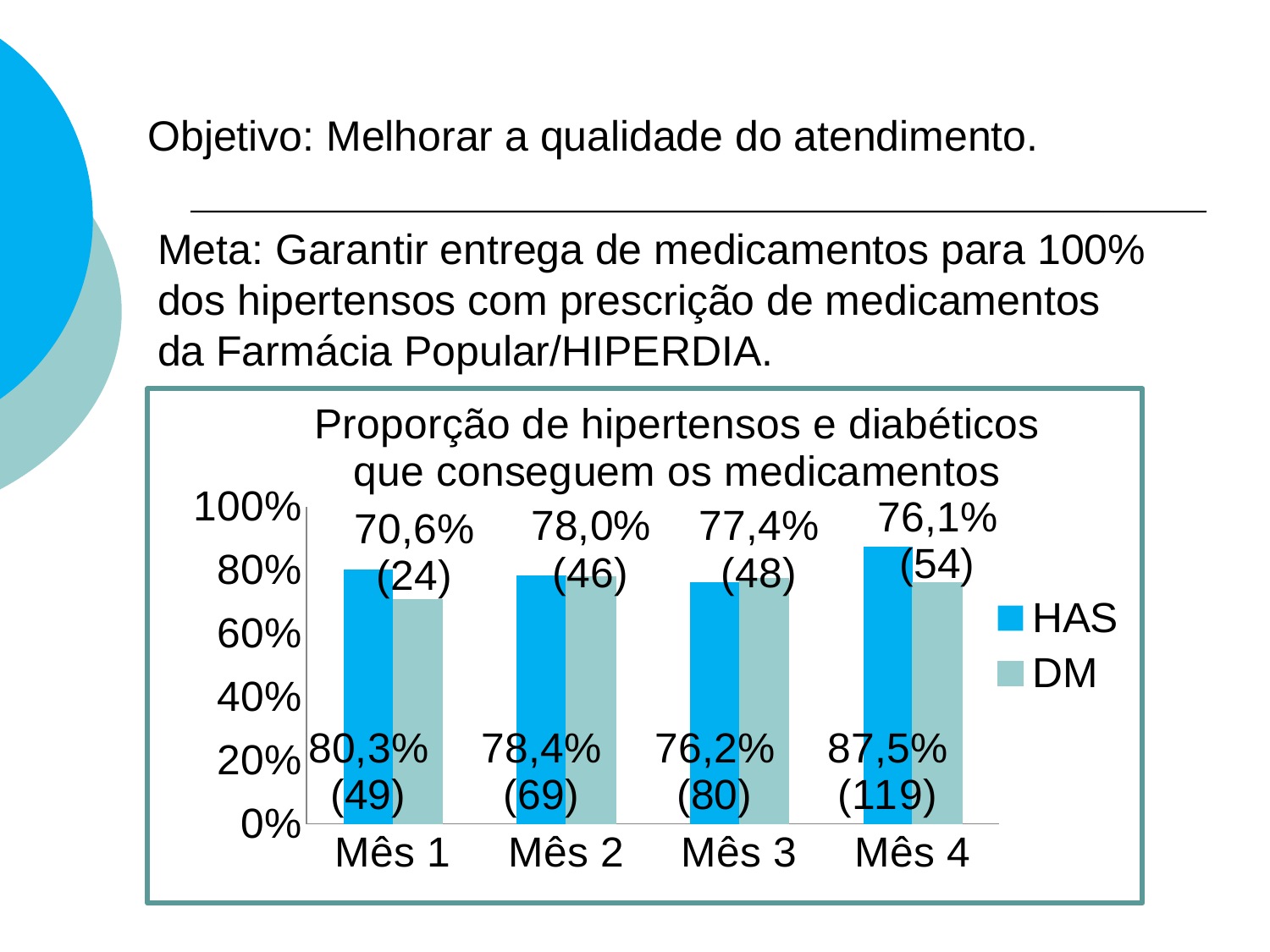
How many months are shown on the x axis? 4 What is the DM value for Mês 3? 77,4% What is the DM value for Mês 1? 70,6% Which is larger for Mês 3, the HAS value or the DM value? DM How many series does the legend list? 2 What kind of chart is shown? Bar chart Which month has the highest HAS value? Mês 4 What is the HAS value for Mês 4? 87,5% What is the difference between the HAS and DM values for Mês 1? 9,7% What is the title of the chart? Proporção de hipertensos e diabéticos que conseguem os medicamentos What is the HAS value for Mês 2? 78,4% Which month has the lowest DM value? Mês 1